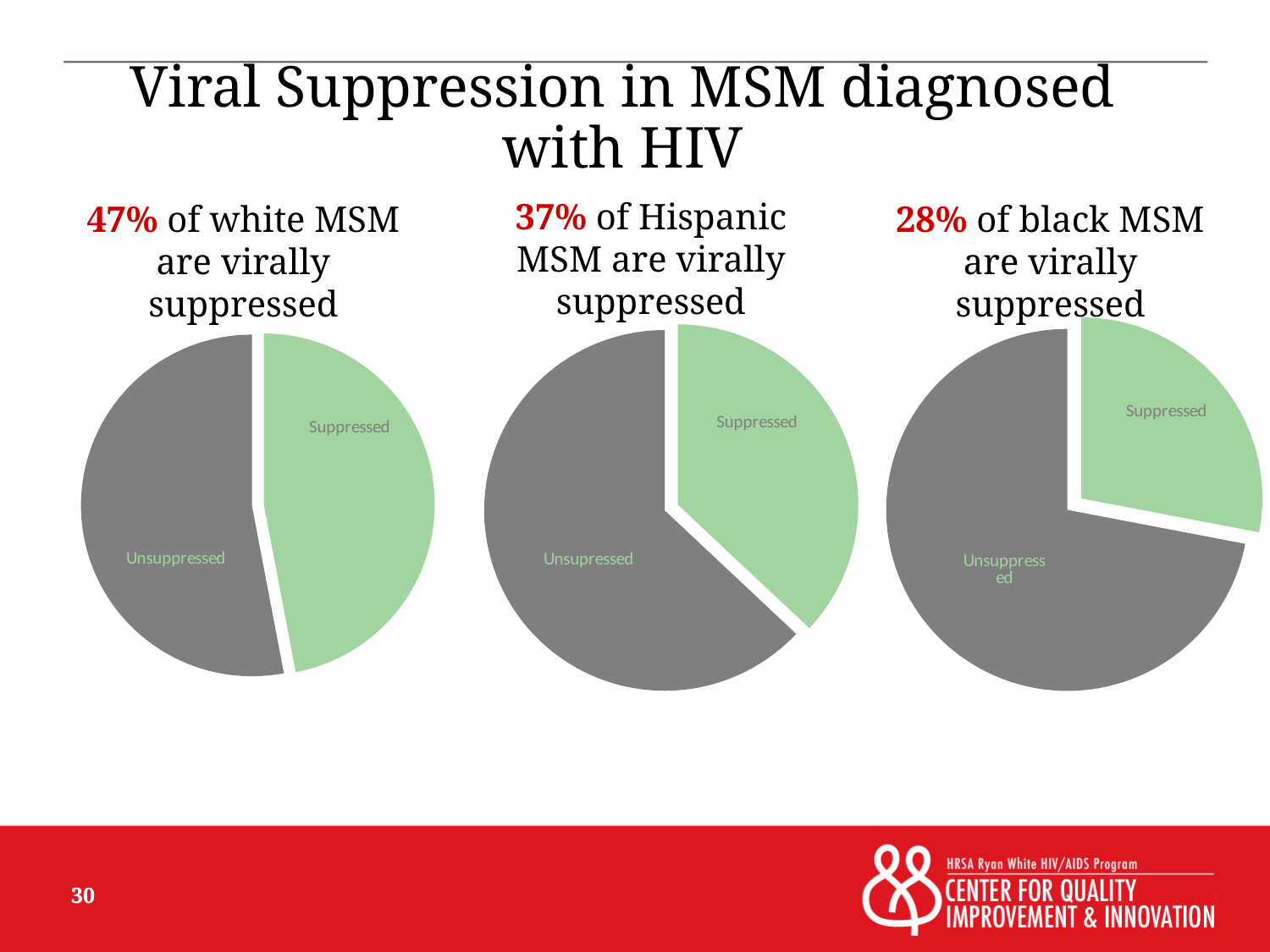
What is the difference in percentage points between the suppressed share for white MSM and for black MSM? 19 How many slices does each pie chart have? 2 Is the Suppressed slice larger in the middle pie chart (Hispanic MSM) or the right pie chart (black MSM)? Hispanic MSM In the right pie chart (black MSM), what share of the pie is the Unsuppressed slice? 72% In the left pie chart (white MSM), what share of the pie is the Unsuppressed slice? 53% What kind of charts are shown on the slide? Pie charts Which of the three pie charts has the largest Suppressed slice? White MSM In the middle pie chart (Hispanic MSM), what share of the pie is the Suppressed slice? 37% How many pie charts are on the slide? 3 Which of the three pie charts has the smallest Suppressed slice? Black MSM